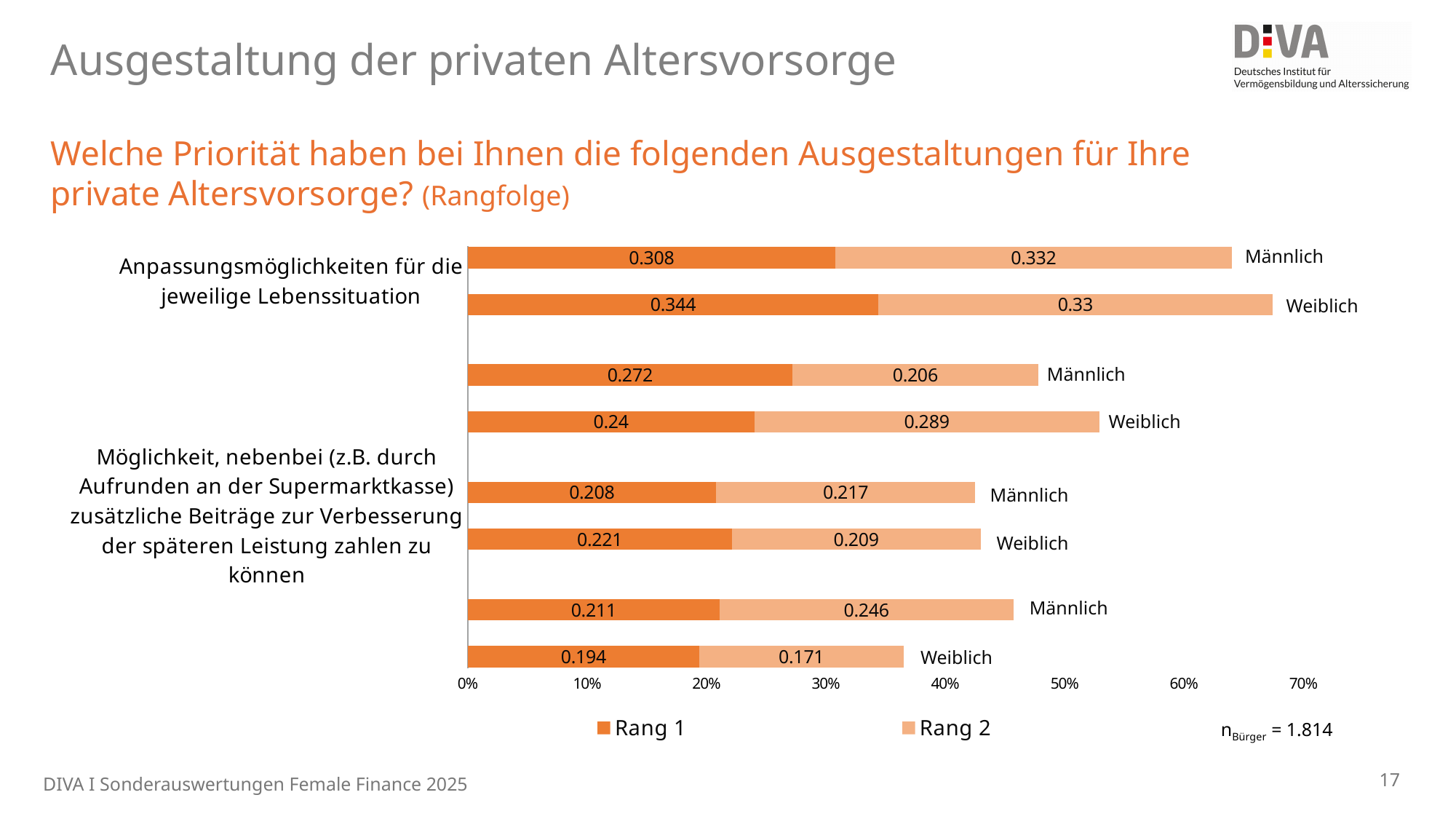
What is the Rang 1 value for Männlich in the category "Anpassungsmöglichkeiten für die jeweilige Lebenssituation"? 0.308 What kind of chart is shown on the slide? Stacked bar chart What is the Rang 2 value for Weiblich in the category "Anpassungsmöglichkeiten für die jeweilige Lebenssituation"? 0.33 How many series does the legend list? 2 What is the Rang 1 value for Weiblich in the category "Möglichkeit, nebenbei (z.B. durch Aufrunden an der Supermarktkasse) zusätzliche Beiträge zur Verbesserung der späteren Leistung zahlen zu können"? 0.221 What is the total of the Weiblich bar (Rang 1 plus Rang 2) for "Anpassungsmöglichkeiten für die jeweilige Lebenssituation"? 0.674 What is the total of the Männlich bar (Rang 1 plus Rang 2) for "Anpassungsmöglichkeiten für die jeweilige Lebenssituation"? 0.64 What is the Rang 2 value for Männlich in the category "Möglichkeit, nebenbei (z.B. durch Aufrunden an der Supermarktkasse) zusätzliche Beiträge zur Verbesserung der späteren Leistung zahlen zu können"? 0.217 For "Anpassungsmöglichkeiten für die jeweilige Lebenssituation", how much higher is the Rang 1 value for Weiblich than for Männlich? 0.036 For "Anpassungsmöglichkeiten für die jeweilige Lebenssituation", which group has the larger Rang 1 value, Männlich or Weiblich? Weiblich Is the total length of the Weiblich bar for "Anpassungsmöglichkeiten für die jeweilige Lebenssituation" greater or less than 60%? greater What are the two entries in the chart legend? Rang 1 and Rang 2